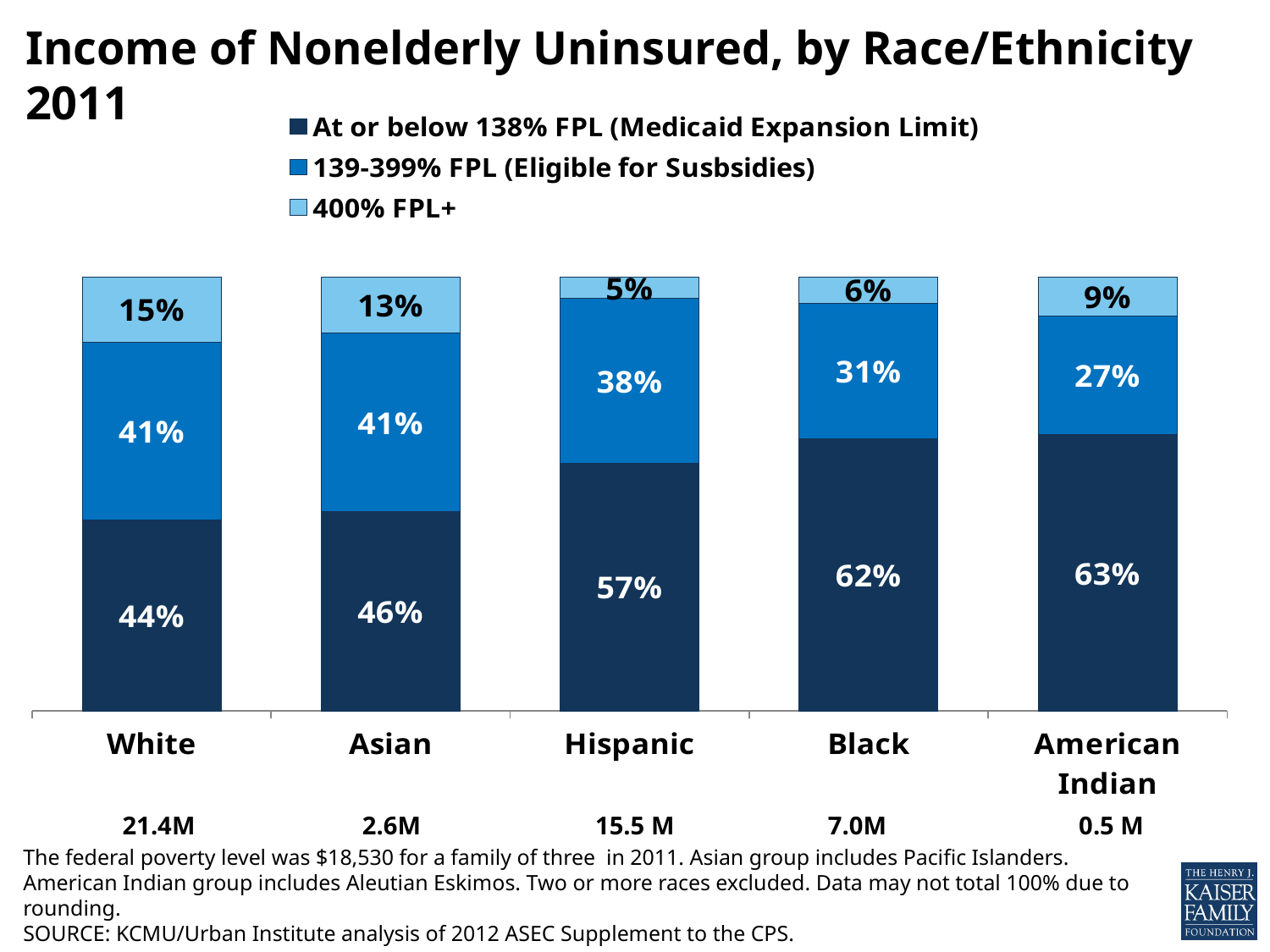
What is the total of the three segments for the Asian bar? 100% What is the number of nonelderly uninsured shown below the Hispanic bar? 15.5 M How many series does the legend list? 3 What is the difference between the Black and White shares at or below 138% FPL? 18 percentage points What share of nonelderly uninsured Hispanic people are in the 139-399% FPL group? 38% What percentage of nonelderly uninsured American Indian people are at 400% FPL+? 9% What kind of chart is shown on the slide? Stacked bar chart What percentage of nonelderly uninsured White people are at or below 138% FPL? 44% Which race/ethnicity group has the highest share at or below 138% FPL? American Indian Which race/ethnicity group has the lowest share at 400% FPL+? Hispanic How many race/ethnicity categories are shown on the x axis? 5 Which group has a larger share in the 139-399% FPL category, Black or American Indian? Black